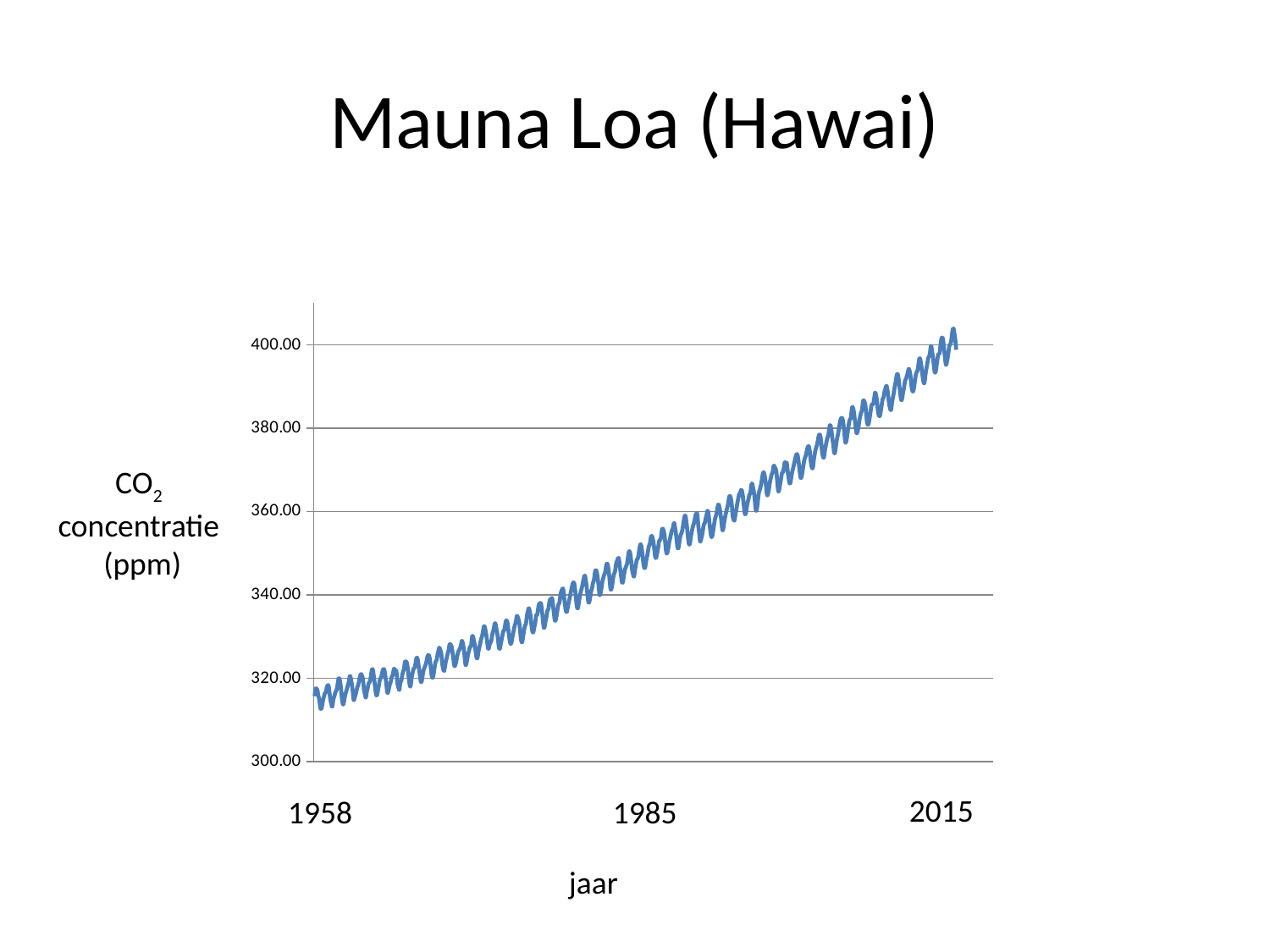
What kind of chart is shown on the slide? line chart What is the label of the x axis? jaar Is the CO2 concentration in 1958 greater or less than 320.00 ppm? less Which of the labelled years, 1958, 1985 or 2015, has the lowest CO2 concentration? 1958 What is the highest value shown on the y axis? 400.00 Is the CO2 concentration in 1985 greater or less than 360.00 ppm? less Do the CO2 concentration values rise or fall from 1958 to 2015? rise Which year has the higher CO2 concentration, 1958 or 2015? 2015 What is the title of the chart on the slide? Mauna Loa (Hawai) Is the CO2 concentration in 2015 greater or less than 380.00 ppm? greater